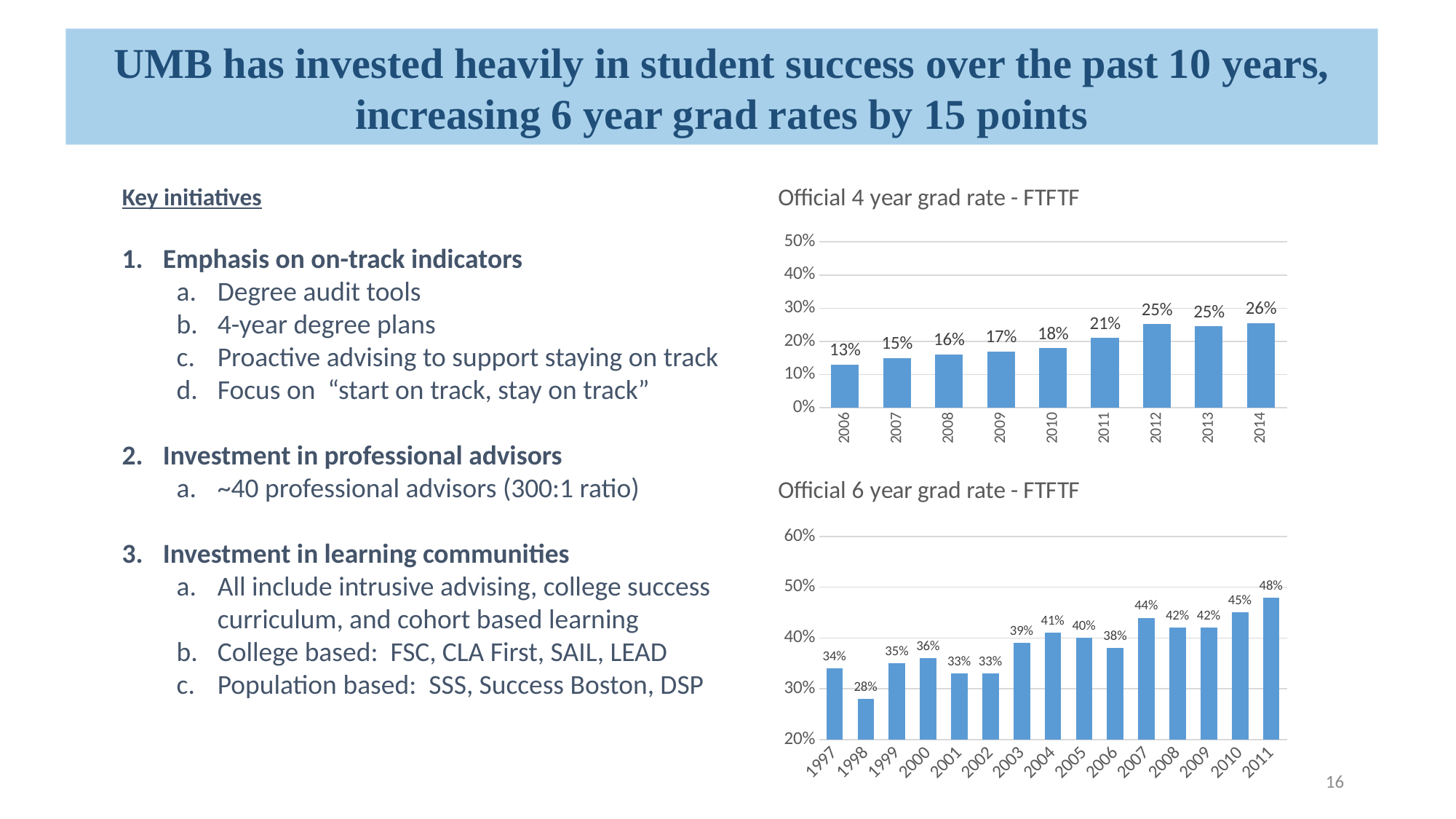
In the 'Official 6 year grad rate - FTFTF' chart, which year has the lowest value? 1998 In the 'Official 4 year grad rate - FTFTF' chart, do the values generally rise or fall from 2006 to 2014? rise In the 'Official 4 year grad rate - FTFTF' chart, what is the difference between the values for 2014 and 2006? 13% In the 'Official 6 year grad rate - FTFTF' chart, what is the value for 1998? 28% What type of chart is the 'Official 6 year grad rate - FTFTF' chart? bar chart In the 'Official 6 year grad rate - FTFTF' chart, which is larger, the value for 2007 or the value for 2006? 2007 In the 'Official 4 year grad rate - FTFTF' chart, what is the value for 2011? 21% In the 'Official 4 year grad rate - FTFTF' chart, which year has the lowest value? 2006 In the 'Official 4 year grad rate - FTFTF' chart, how many years are shown? 9 In the 'Official 6 year grad rate - FTFTF' chart, how many years are shown? 15 In the 'Official 4 year grad rate - FTFTF' chart, which year has the highest value? 2014 In the 'Official 6 year grad rate - FTFTF' chart, which year has the highest value? 2011